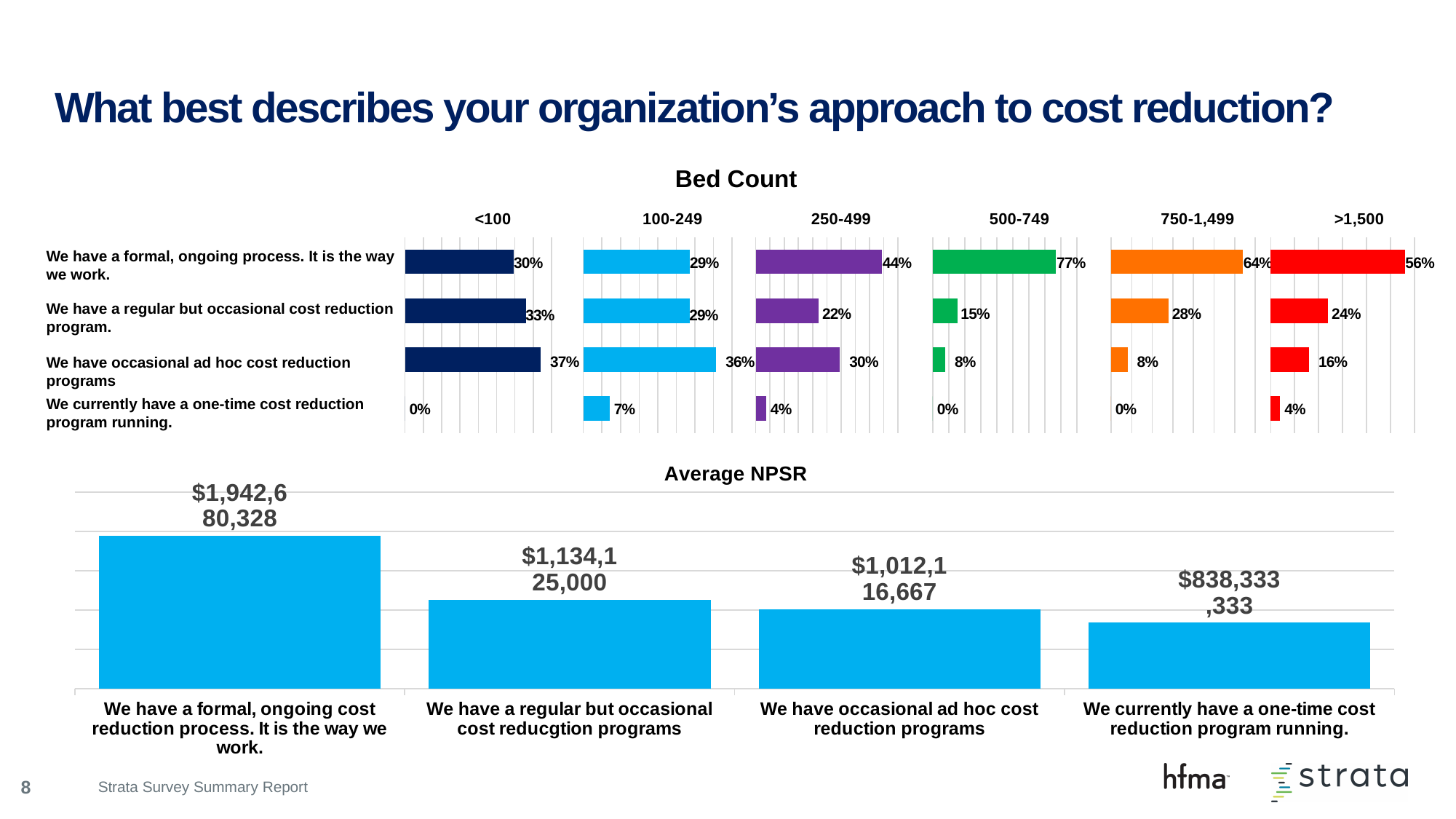
In the Bed Count chart, what percentage of organizations with 100-249 beds currently have a one-time cost reduction program running? 7% In the Bed Count chart, what percentage of organizations with 500-749 beds said they have a formal, ongoing process? 77% In the Average NPSR chart, which category has the lowest average NPSR? We currently have a one-time cost reduction program running. In the Average NPSR chart, what is the value for 'We currently have a one-time cost reduction program running.'? $838,333,333 In the Bed Count chart, what is the difference between the 750-1,499 and >1,500 percentages for 'We have a formal, ongoing process'? 8% How many bed count groups are shown in the Bed Count chart? 6 In the Average NPSR chart, what is the value for 'We have a formal, ongoing cost reduction process. It is the way we work.'? $1,942,680,328 In the Bed Count chart, which is larger for the 250-499 group: the formal, ongoing process percentage or the occasional ad hoc programs percentage? Formal, ongoing process (44%) In the Bed Count chart, what percentage of organizations with <100 beds said they have occasional ad hoc cost reduction programs? 37% What type of chart is the Average NPSR chart? Bar chart In the Bed Count chart, which bed count group has the highest percentage for 'We have a formal, ongoing process. It is the way we work.'? 500-749 In the Bed Count chart, which bed count group has the lowest percentage for 'We have a regular but occasional cost reduction program.'? 500-749